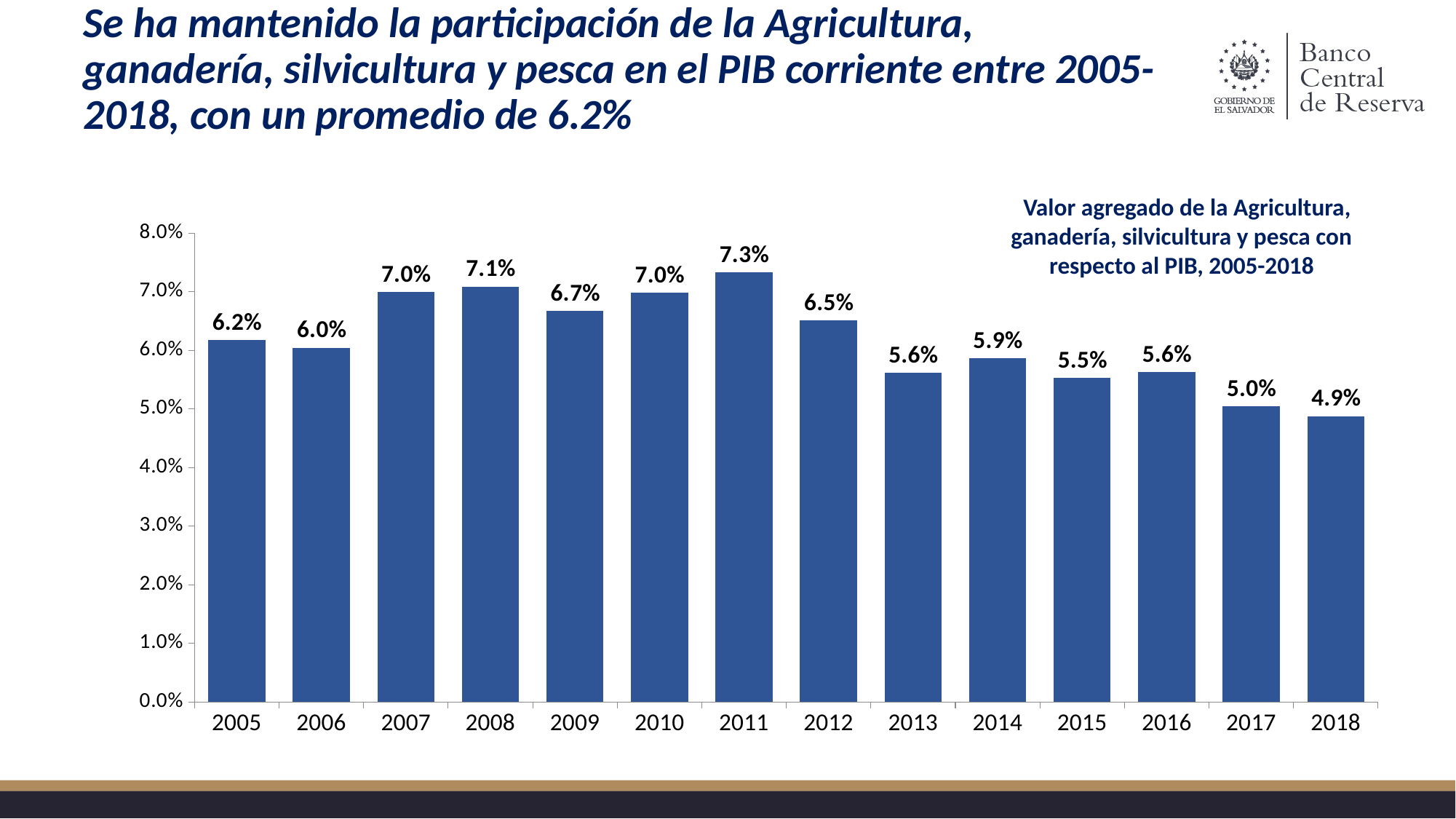
What is the difference between the values for 2011 and 2018? 2.4% What is the title of the chart? Valor agregado de la Agricultura, ganadería, silvicultura y pesca con respecto al PIB, 2005-2018 How many years are shown on the x axis? 14 Which year has the highest value? 2011 What is the value for 2011? 7.3% What is the value for 2005? 6.2% Which is larger, the value for 2008 or the value for 2012? 2008 Is the value for 2014 greater or less than 6.0%? less Which year has the lowest value? 2018 Do the values generally rise or fall from 2011 to 2018? fall What is the value for 2018? 4.9% What kind of chart is shown on the slide? bar chart